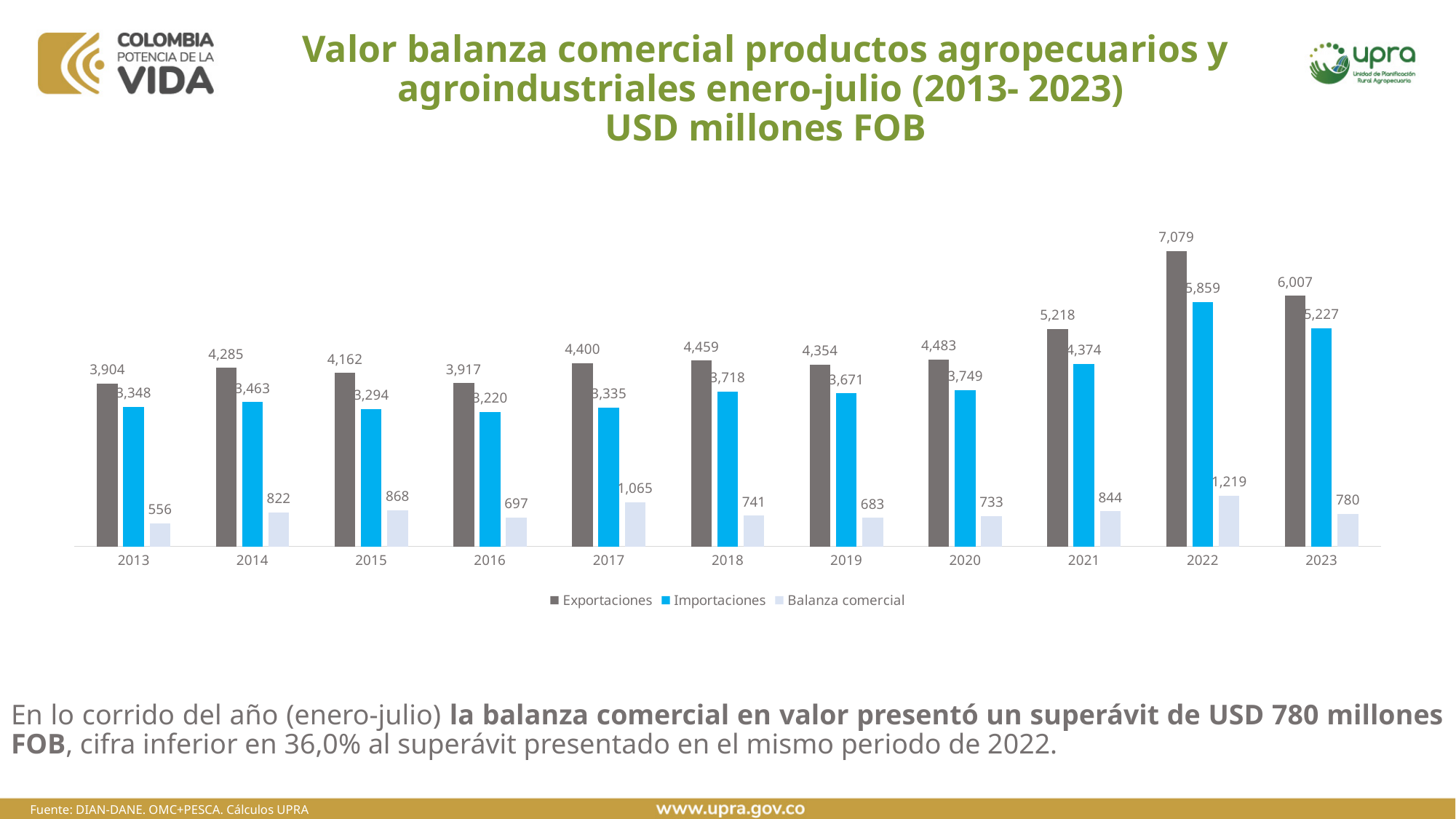
In which year is Exportaciones highest? 2022 What is the difference between Exportaciones in 2022 and Exportaciones in 2023? 1,072 What is the value of Exportaciones for 2023? 6,007 What kind of chart is shown on the slide? Bar chart In which year is Balanza comercial lowest? 2013 What is the value of Importaciones for 2019? 3,671 Which is larger, Importaciones in 2021 or Importaciones in 2020? Importaciones in 2021 What is the difference between Balanza comercial in 2022 and Balanza comercial in 2023? 439 What is the value of Balanza comercial for 2017? 1,065 How many series does the legend list? 3 How many years are shown on the x axis? 11 Do the Exportaciones values rise or fall from 2020 to 2022? Rise